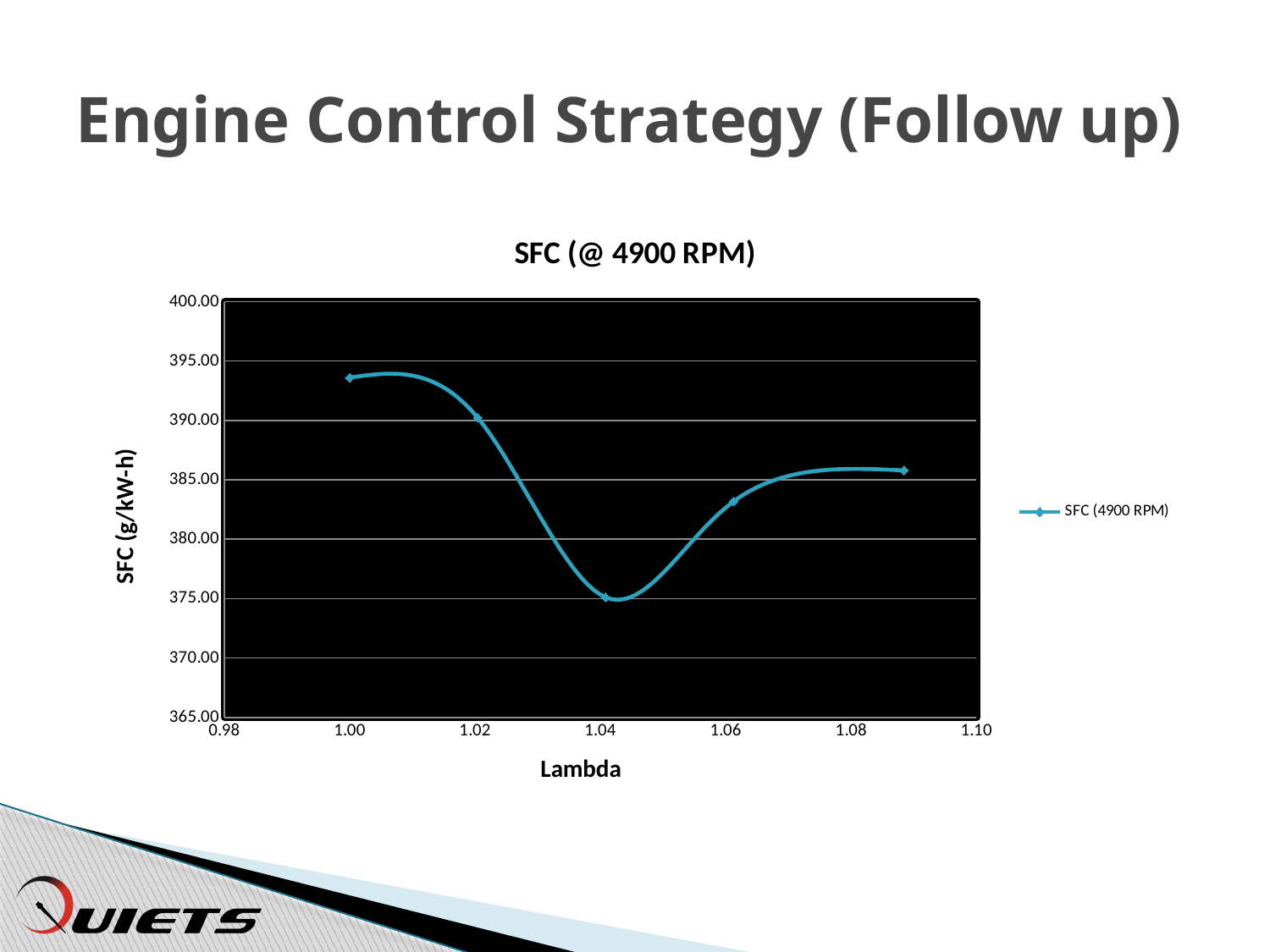
Is the SFC value at Lambda 1.04 greater or less than 380.00? less Is the SFC value at Lambda 1.00 greater or less than 390.00? greater What is the label of the y axis? SFC (g/kW-h) At which Lambda value is the SFC highest? 1.00 At which Lambda value is the SFC lowest? 1.04 What is the title of the chart? SFC (@ 4900 RPM) Which has the larger SFC value, Lambda 1.02 or Lambda 1.06? Lambda 1.02 How many data points are plotted on the line? 5 Is the SFC value at Lambda 1.06 greater or less than 380.00? greater What kind of chart is shown on the slide? line chart Does the SFC rise or fall as Lambda increases from 1.00 to 1.04? fall How many series does the legend list? 1